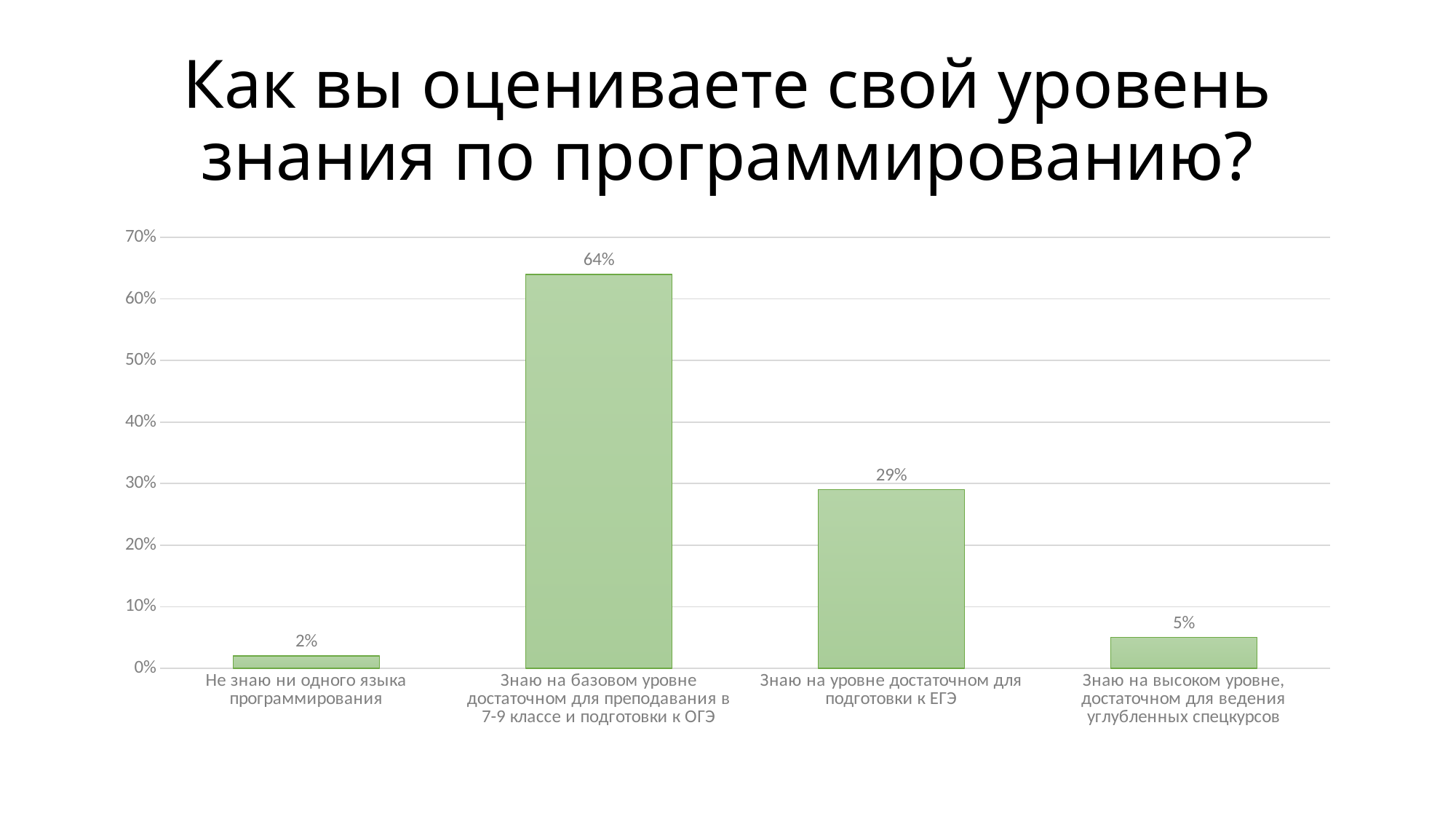
Is the value for "Знаю на уровне достаточном для подготовки к ЕГЭ" greater or less than 20%? greater What is the value for "Знаю на уровне достаточном для подготовки к ЕГЭ"? 29% Which is larger: the value for "Знаю на высоком уровне..." or the value for "Не знаю ни одного языка программирования"? Знаю на высоком уровне, достаточном для ведения углубленных спецкурсов What kind of chart is shown on the slide? Bar chart What is the difference between the values for "Знаю на базовом уровне..." (64%) and "Знаю на уровне достаточном для подготовки к ЕГЭ" (29%)? 35% What is the value for "Не знаю ни одного языка программирования"? 2% What percentage of respondents answered "Знаю на базовом уровне достаточном для преподавания в 7-9 классе и подготовки к ОГЭ"? 64% Which category has the lowest value? Не знаю ни одного языка программирования How many categories are shown on the chart? 4 What is the value for "Знаю на высоком уровне, достаточном для ведения углубленных спецкурсов"? 5% Which category has the highest value? Знаю на базовом уровне достаточном для преподавания в 7-9 классе и подготовки к ОГЭ What is the title of the slide? Как вы оцениваете свой уровень знания по программированию?